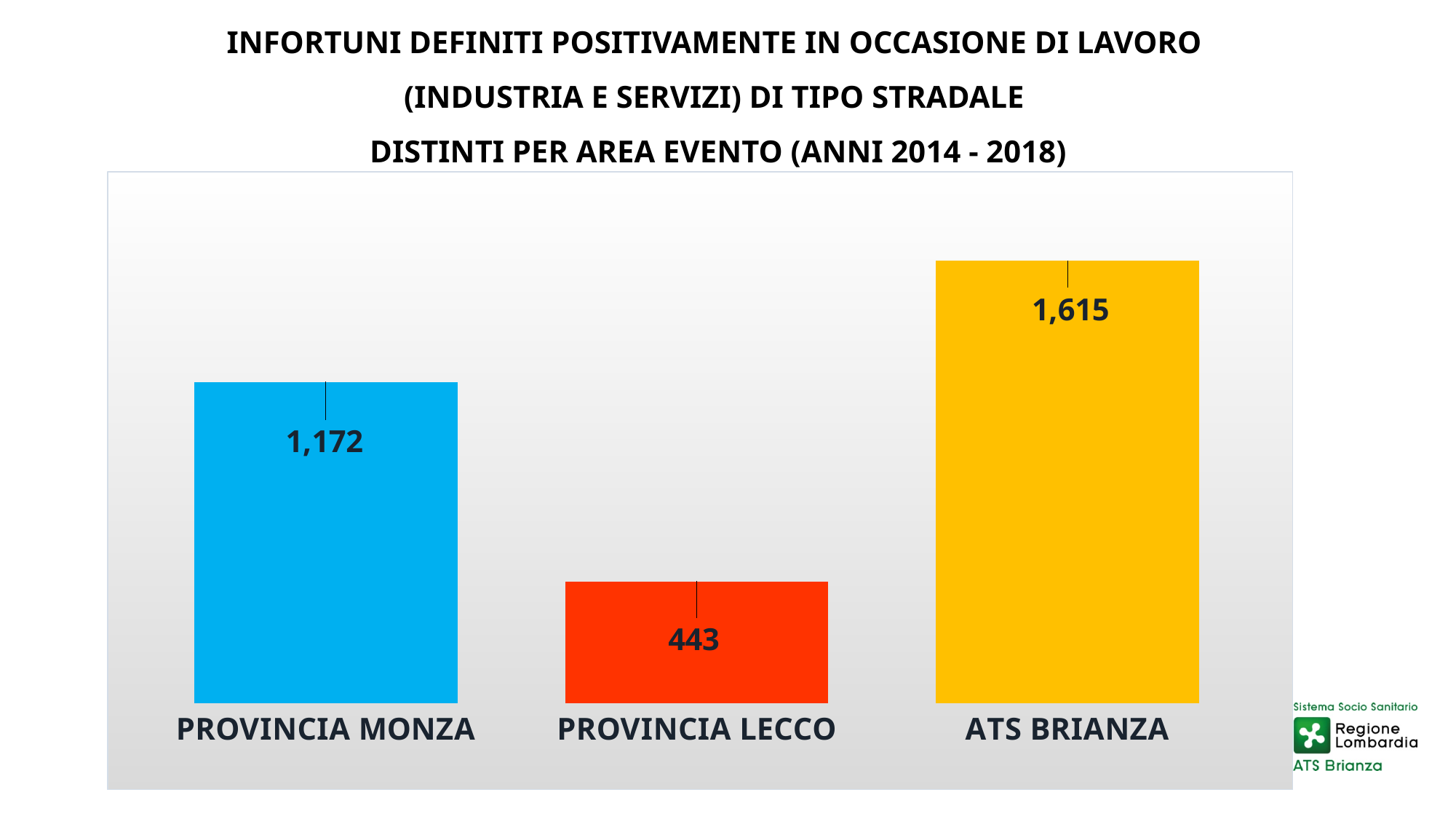
What is the value for PROVINCIA MONZA? 1,172 Which category has the lowest value? PROVINCIA LECCO What colour is the bar for ATS BRIANZA? Yellow What is the value for ATS BRIANZA? 1,615 What is the difference between the values for PROVINCIA MONZA and PROVINCIA LECCO? 729 What colour is the bar for PROVINCIA LECCO? Red What kind of chart is shown on the slide? Bar chart How many categories are shown in the chart? 3 Which is larger, the value for PROVINCIA MONZA or the value for PROVINCIA LECCO? PROVINCIA MONZA What is the value for PROVINCIA LECCO? 443 Which category has the highest value? ATS BRIANZA What is the difference between the values for ATS BRIANZA and PROVINCIA MONZA? 443